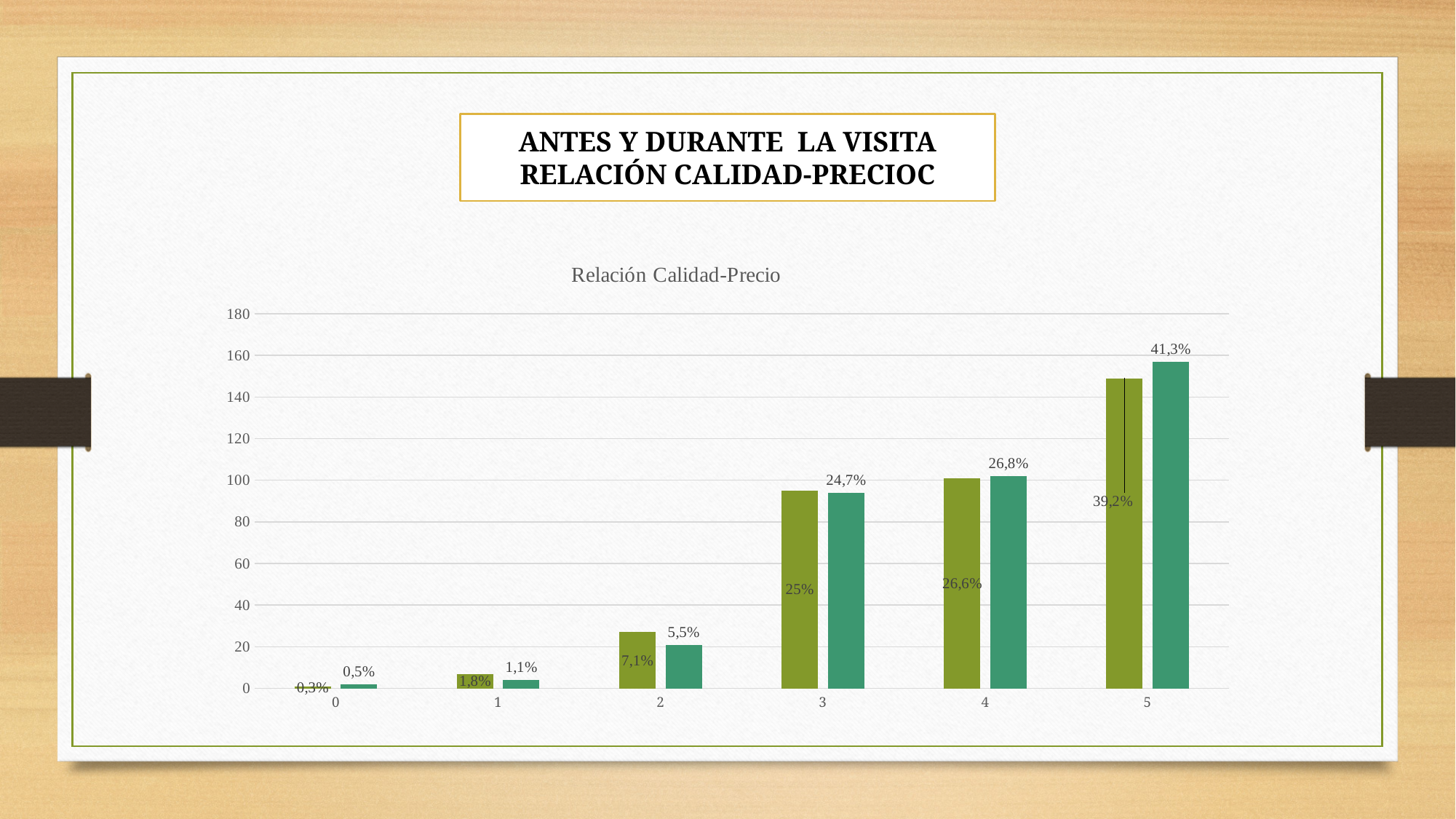
What is the difference between the data labels of the two bars for category 5? 2,1% Which category has the tallest bars in the chart? 5 How many categories are shown on the x axis of the chart? 6 What is the data label on the left-hand (olive green) bar for category 5? 39,2% Which category has the shortest bars in the chart? 0 Is the value of the left-hand (olive green) bar for category 4 greater or less than 80 on the y axis? greater What is the title of the chart? Relación Calidad-Precio What type of chart is shown on the slide? bar chart For category 5, which bar is taller: the left-hand (olive green) bar or the right-hand (dark green) bar? the right-hand (dark green) bar What is the data label on the right-hand (dark green) bar for category 5? 41,3% What is the data label on the right-hand (dark green) bar for category 3? 24,7% What is the data label on the left-hand (olive green) bar for category 2? 7,1%